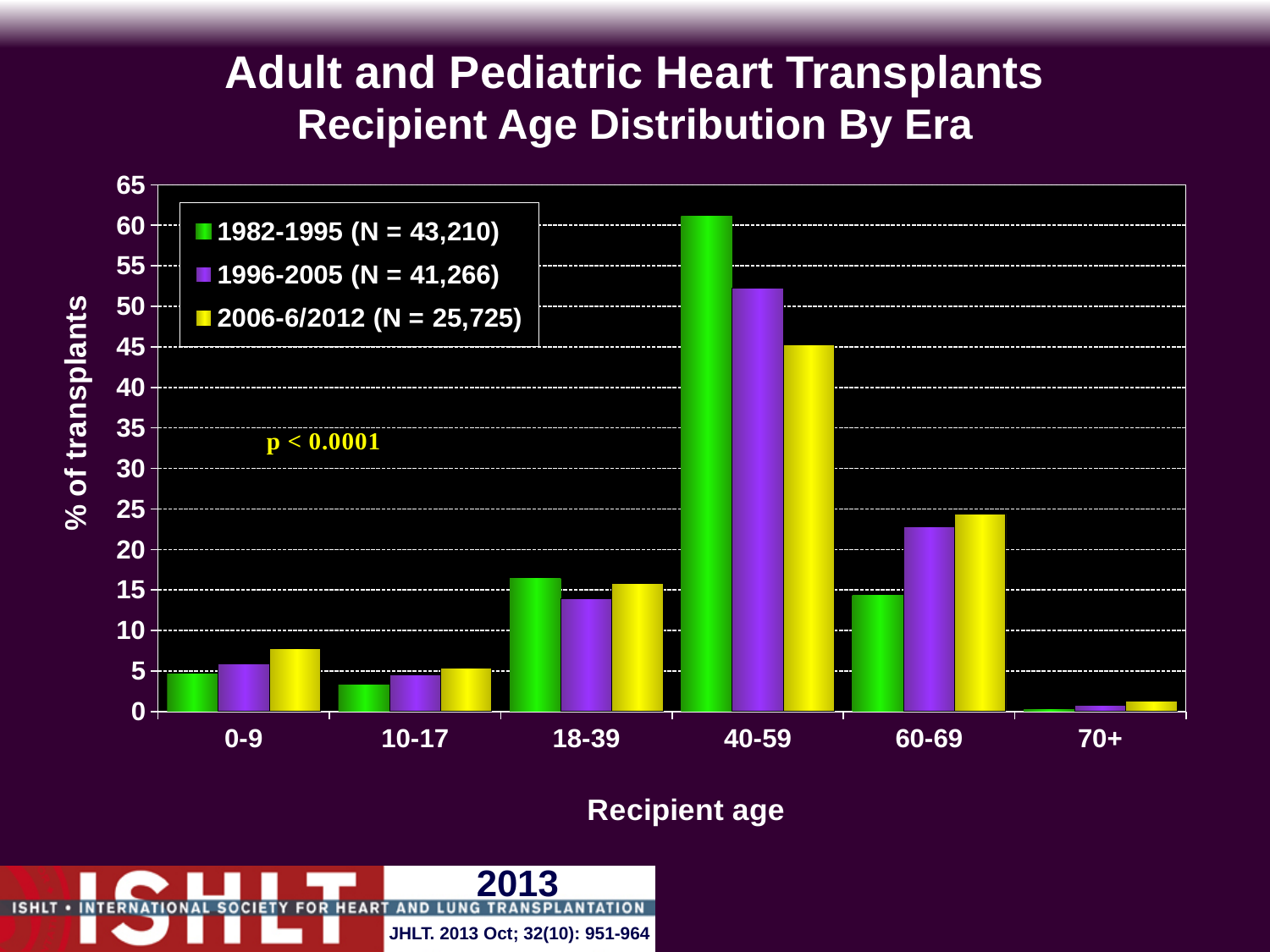
How many series does the legend list? 3 What kind of chart is shown on the slide? bar chart Which recipient age group has the lowest value for the 2006-6/2012 series? 70+ Which recipient age group has the highest value for the 1982-1995 series? 40-59 What p-value is printed on the chart? p < 0.0001 In the 60-69 age group, which series has the larger value: 1982-1995 or 2006-6/2012? 2006-6/2012 Is the value for the 1996-2005 series in the 60-69 age group greater or less than 20? greater In the 40-59 age group, which series has the larger value: 1982-1995 or 1996-2005? 1982-1995 According to the legend, what is N for the 1982-1995 series? 43,210 Is the value for the 2006-6/2012 series in the 40-59 age group greater or less than 50? less Is the value for the 1982-1995 series in the 40-59 age group greater or less than 55? greater How many recipient age categories are shown on the x axis? 6